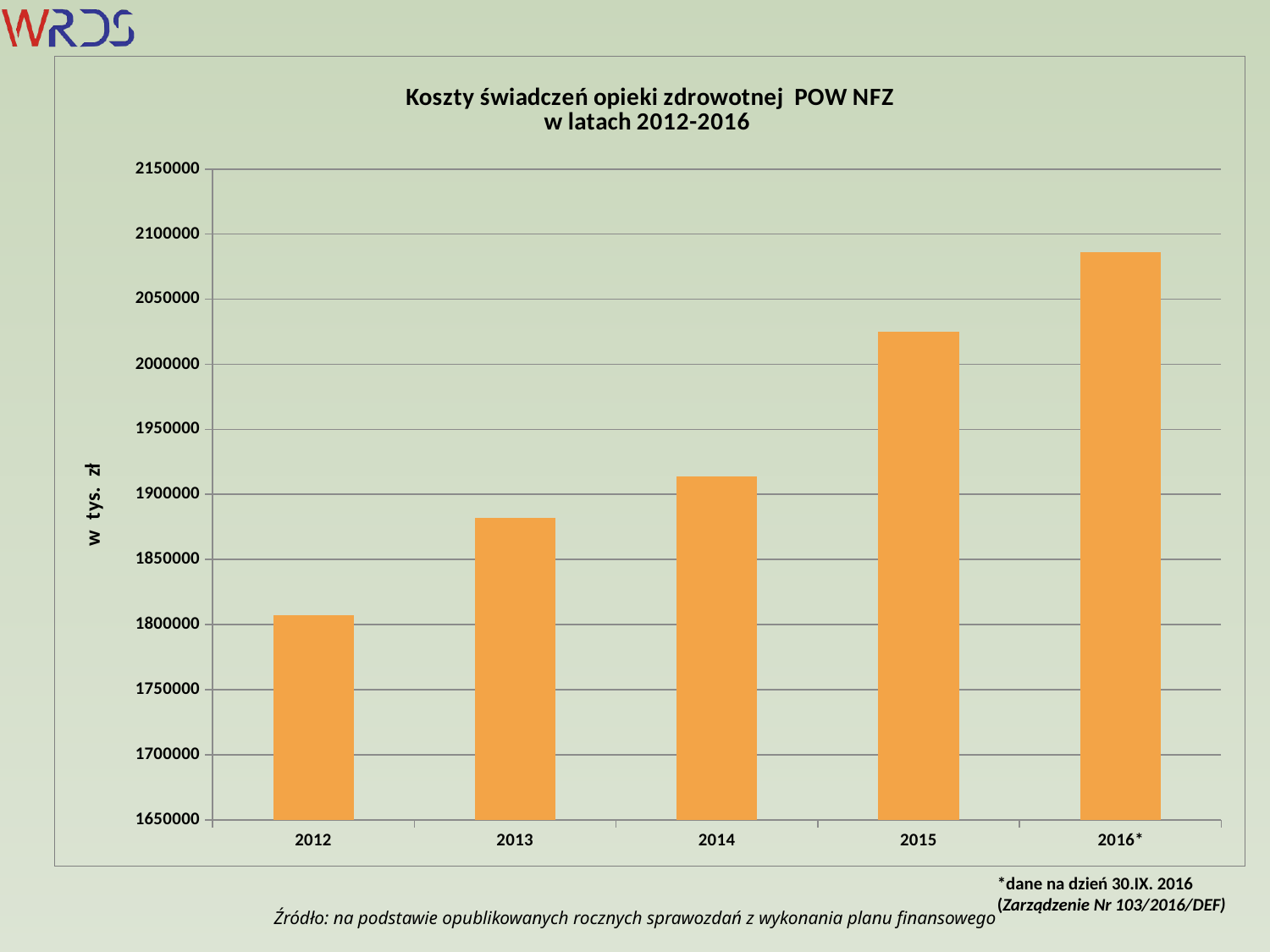
Which year has the lowest value on the chart? 2012 Is the value for 2014 greater or less than 1900000? greater Is the value for 2016* greater or less than 2100000? less Is the value for 2012 greater or less than 1850000? less Which year has the highest value on the chart? 2016* Which is larger, the value for 2014 or the value for 2015? 2015 What is the title of the chart? Koszty świadczeń opieki zdrowotnej POW NFZ w latach 2012-2016 What kind of chart is shown on the slide? bar chart Do the values rise or fall from 2012 to 2016? rise How many years (bars) are shown on the chart? 5